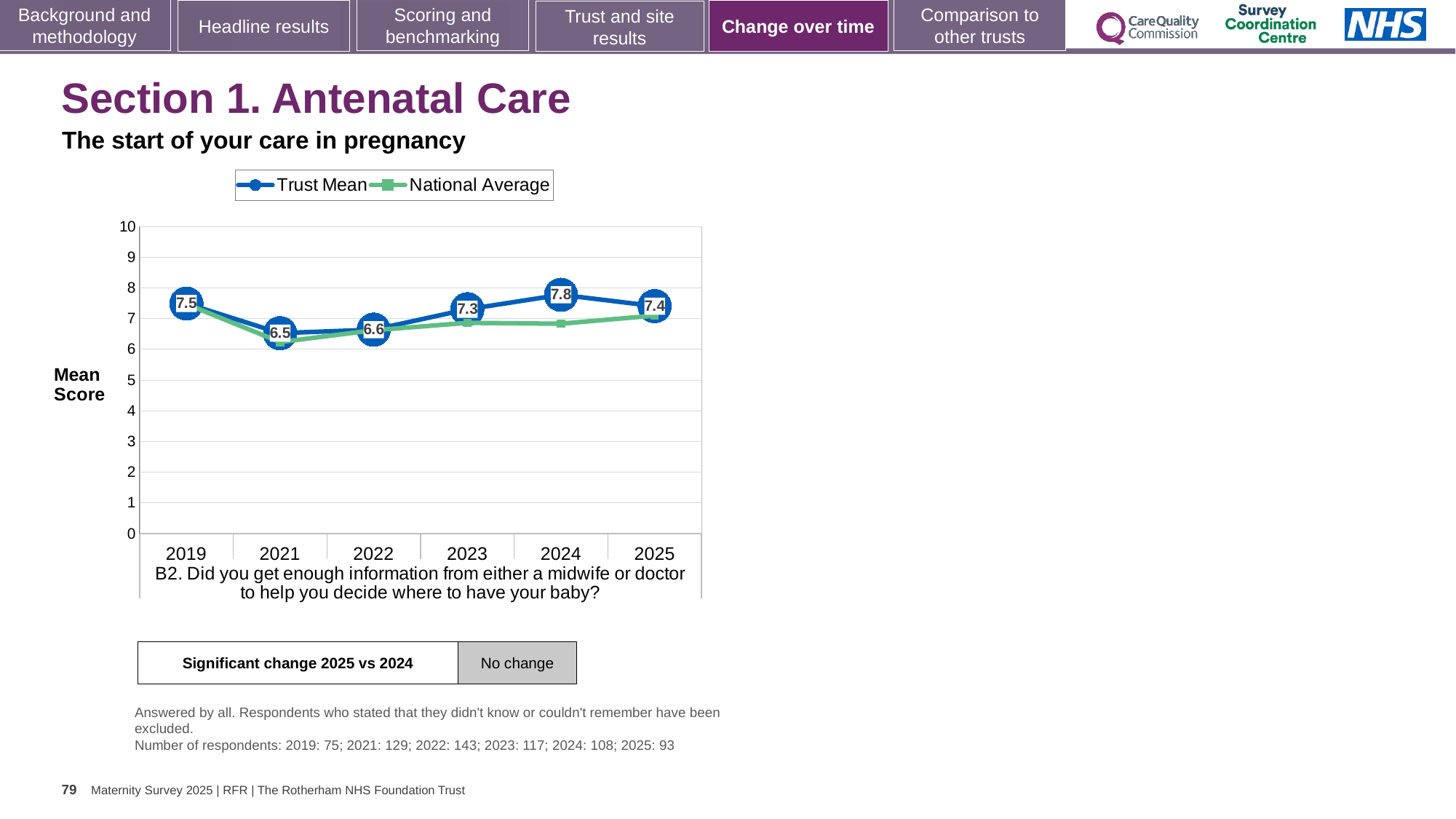
What is the Trust Mean score for 2019? 7.5 In which year is the Trust Mean highest? 2024 How many years are shown on the x axis? 6 Is the National Average for 2021 greater or less than 7? less What is the difference between the Trust Mean in 2024 and in 2025? 0.4 What is the Trust Mean score for 2021? 6.5 What kind of chart is shown? line chart Which is larger, the Trust Mean in 2023 or in 2022? 2023 What is the Trust Mean score for 2024? 7.8 Does the Trust Mean rise or fall from 2021 to 2024? rise In which year is the Trust Mean lowest? 2021 How many series does the legend list? 2